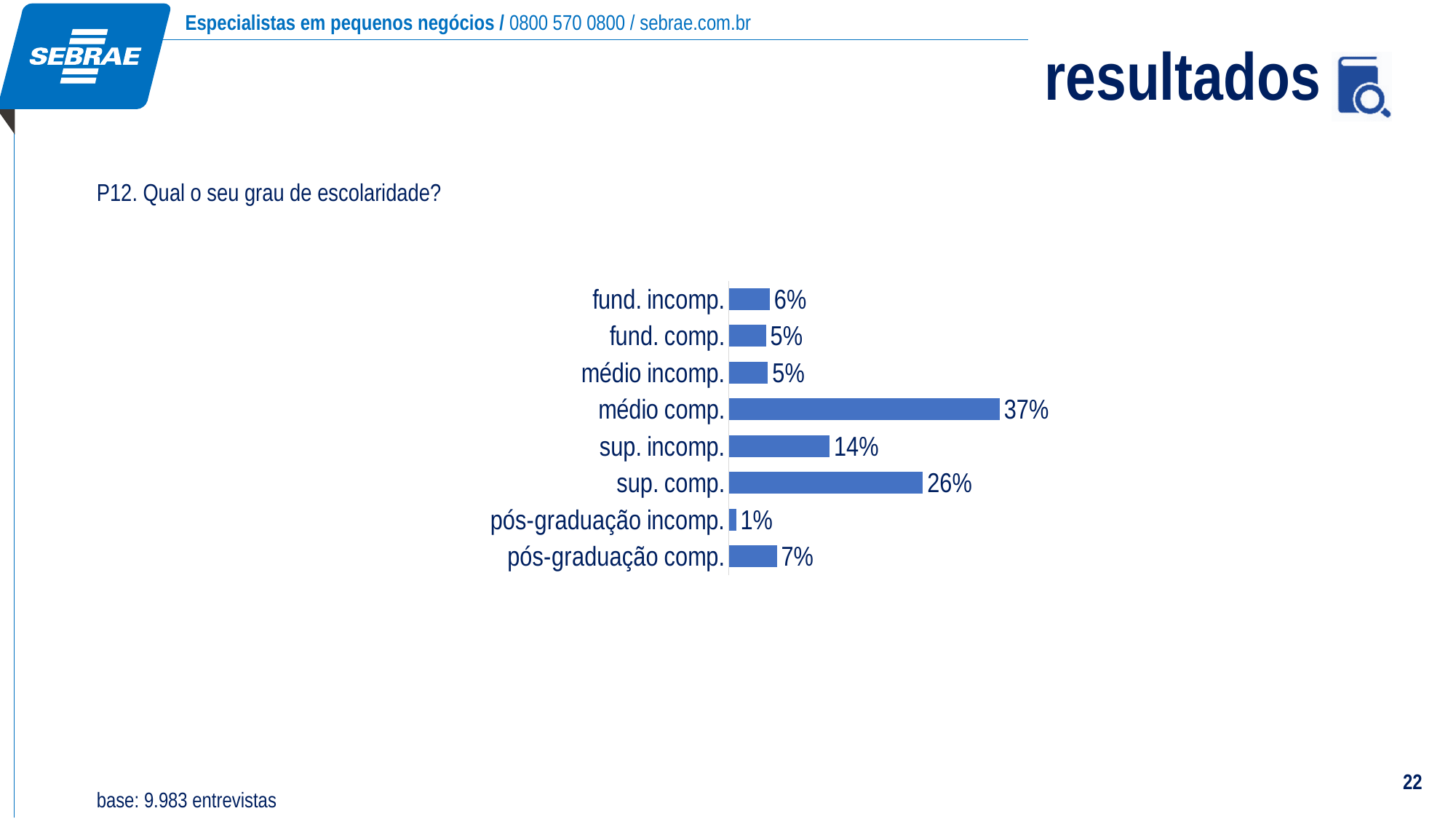
How many categories are shown in the chart? 8 What is the value for sup. incomp.? 14% Which category has the lowest value? pós-graduação incomp. What kind of chart is shown on the slide? bar chart Which is larger, the value for fund. incomp. or the value for pós-graduação comp.? pós-graduação comp. What is the difference between the values for sup. comp. and sup. incomp.? 12% What is the survey question shown above the chart? P12. Qual o seu grau de escolaridade? What is the value for médio comp.? 37% What is the value for pós-graduação comp.? 7% Which is larger, the value for sup. incomp. or the value for sup. comp.? sup. comp. What is the difference between the values for médio comp. and sup. comp.? 11% Which category has the highest value? médio comp.